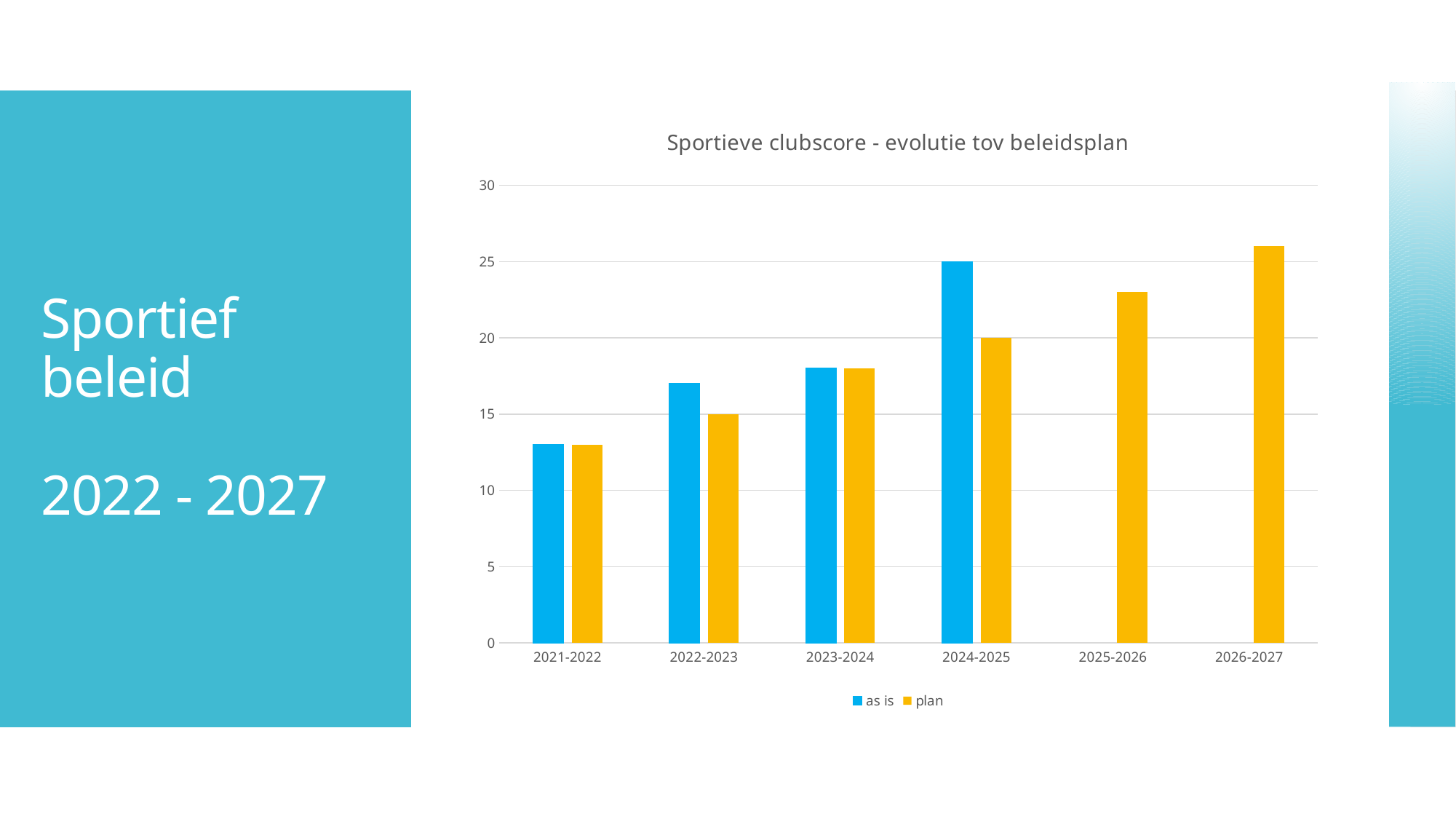
What kind of chart is shown on the slide? bar chart What is the 'plan' value for 2022-2023? 15 How many season categories are shown on the x axis? 6 What is the 'plan' value for 2024-2025? 20 Which season has the lowest 'as is' value? 2021-2022 What is the 'as is' value for 2024-2025? 25 For 2024-2025, which is larger: the 'as is' value or the 'plan' value? as is What is the title of the chart? Sportieve clubscore - evolutie tov beleidsplan How many series does the legend list? 2 Which season has the highest 'plan' value? 2026-2027 Is the 'plan' value for 2026-2027 greater or less than 25? greater Do the 'plan' values rise or fall from 2021-2022 to 2026-2027? rise